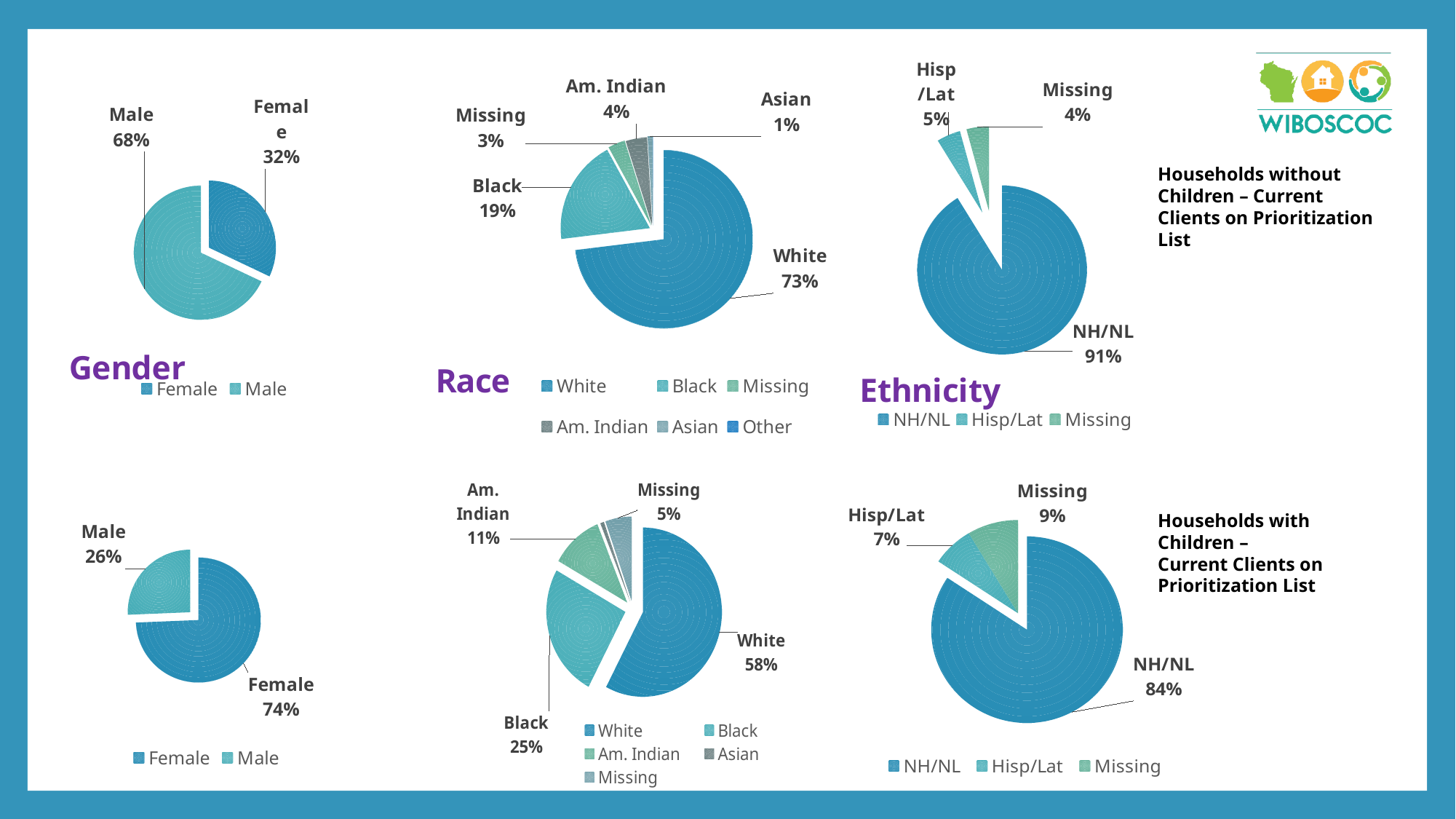
In the top-row Ethnicity pie chart (Households without Children), what share is NH/NL? 91% In the bottom-row Gender pie chart (Households with Children), which is larger, Female or Male? Female In the bottom-row Ethnicity pie chart (Households with Children), which is larger, Hisp/Lat or Missing? Missing In the top-row Race pie chart (Households without Children), which category has the smallest labelled share? Asian In the bottom-row Gender pie chart (Households with Children), what share is Female? 74% In the top-row Gender pie chart (Households without Children), what share is Male? 68% In the top-row Race pie chart (Households without Children), what share is Black? 19% In the top-row Ethnicity pie chart (Households without Children), what is the difference between the Hisp/Lat and Missing shares? 1% What type of chart is used for the Ethnicity data on this slide? Pie chart How many entries does the legend of the top-row Race pie chart (Households without Children) list? 6 In the bottom-row Race pie chart (Households with Children), what share is Am. Indian? 11% In the bottom-row Race pie chart (Households with Children), what is the difference between the White and Black shares? 33%